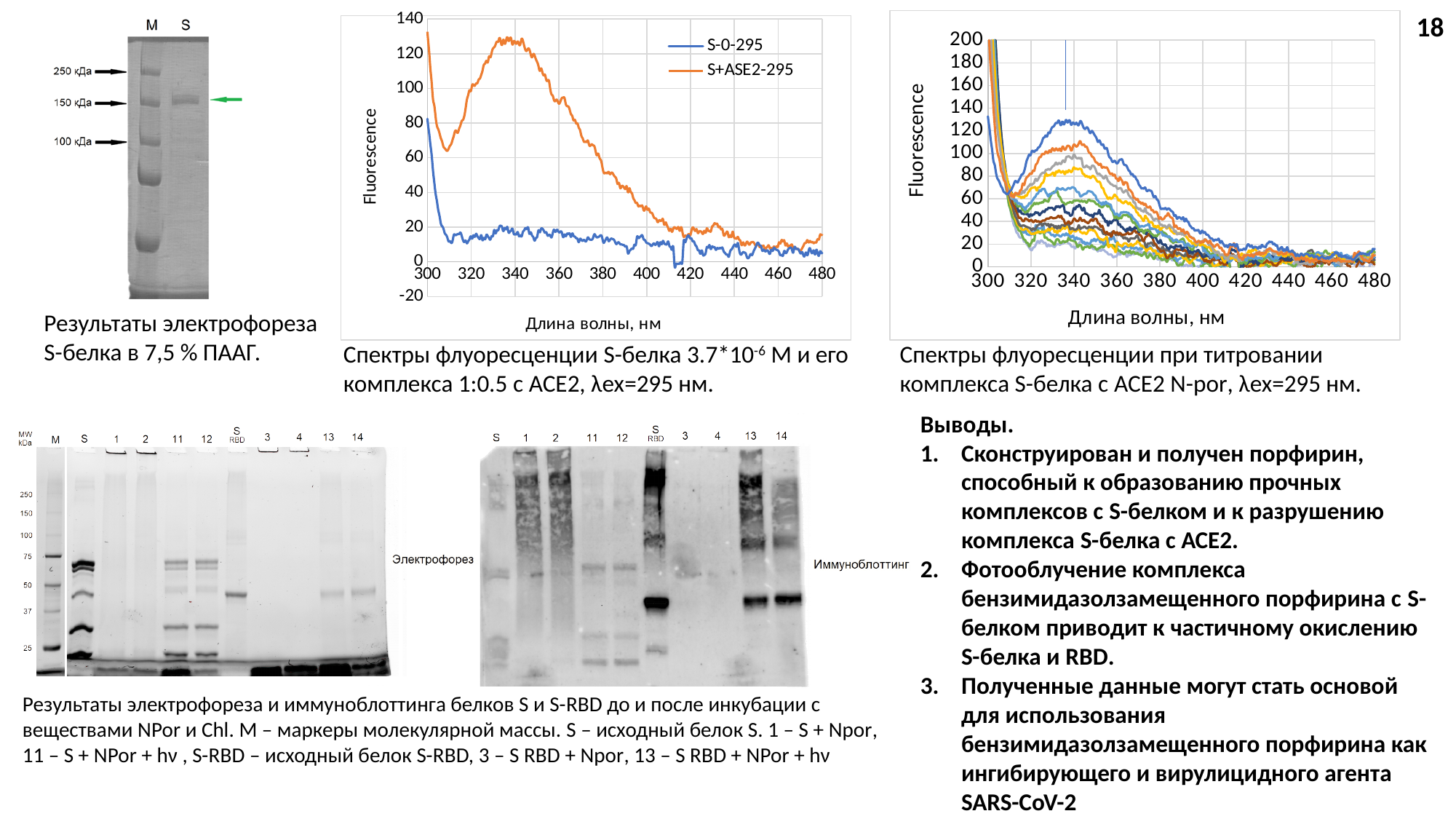
What kind of chart is the right-hand chart showing fluorescence spectra during titration? line chart What kind of chart is the middle chart with the legend entries S-0-295 and S+ASE2-295? line chart In the middle chart (S-0-295 / S+ASE2-295), does the S+ASE2-295 series rise or fall between 340 nm and 480 nm? fall In the middle chart (S-0-295 / S+ASE2-295), is the peak value of S+ASE2-295 near 340 nm greater or less than 100? greater In the middle chart (S-0-295 / S+ASE2-295), which series is larger at 340 nm, S-0-295 or S+ASE2-295? S+ASE2-295 In the middle chart (S-0-295 / S+ASE2-295), is the value of S-0-295 at 340 nm greater or less than 40? less In the middle chart (S-0-295 / S+ASE2-295), which series reaches the higher fluorescence peak? S+ASE2-295 What is the x-axis label of the middle chart (S-0-295 / S+ASE2-295)? Длина волны, нм What is the maximum value shown on the y-axis of the right-hand titration chart? 200 In the right-hand titration chart, is the peak of the highest (blue) curve near 340 nm greater or less than 100? greater In the middle chart (S-0-295 / S+ASE2-295), how many series does the legend list? 2